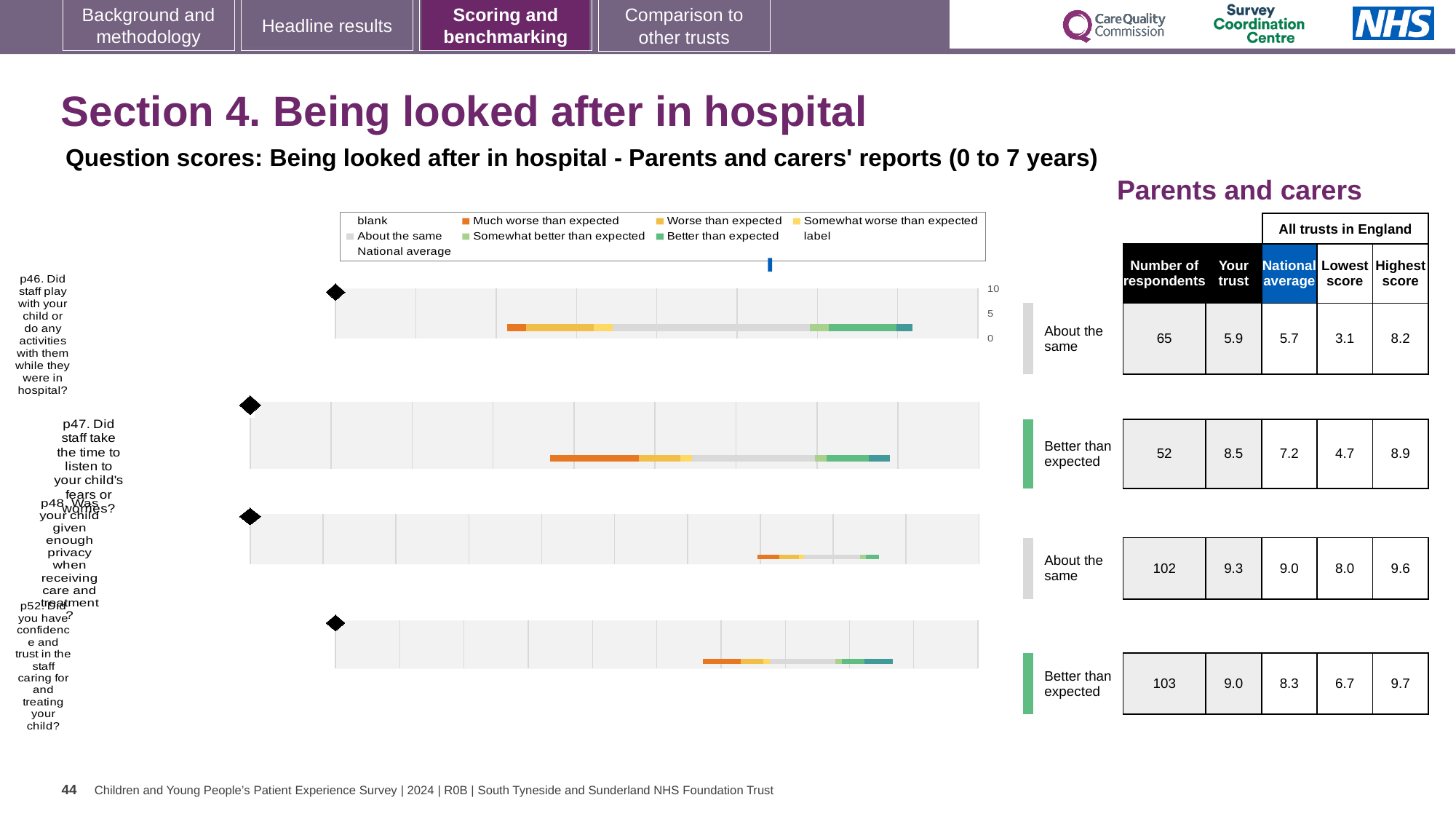
How many survey questions (charts) are shown on the slide? 4 What is the highest score among all trusts in England for p46? 8.2 What kind of chart is used to show the question scores on this slide? Bar chart For p47, what is the difference between the 'Your trust' score and the national average? 1.3 Which question has the highest 'Your trust' score in the table? p48 For p52, which is larger: the 'Your trust' score or the national average? Your trust How many respondents are listed for p52? 103 What benchmark category is shown for p52 (Did you have confidence and trust in the staff caring for and treating your child?)? Better than expected Which question has the lowest number of respondents? p47 For p47 (Did staff take the time to listen to your child's fears or worries?), what is the 'Your trust' score shown in the table? 8.5 What benchmark category is shown for p46 (Did staff play with your child or do any activities with them while they were in hospital?)? About the same What is the lowest score among all trusts in England for p48? 8.0